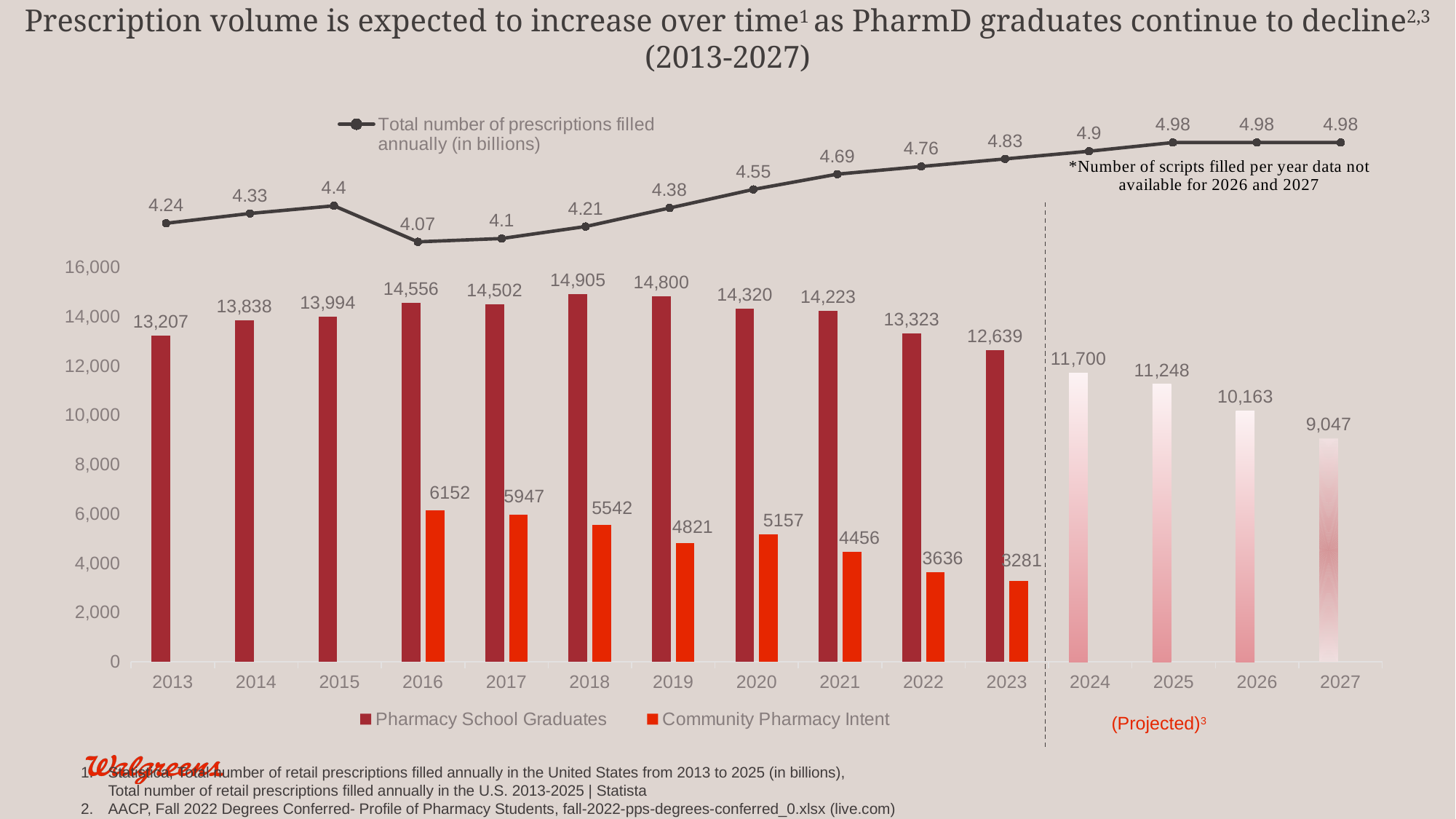
What is the total number of prescriptions filled annually (in billions) shown for 2023? 4.83 What is the value for Pharmacy School Graduates in 2018? 14,905 In which year is the Pharmacy School Graduates value highest? 2018 What kind of chart is shown on the slide? Combined bar and line chart How many years are shown on the x axis? 15 In which year is the Community Pharmacy Intent value lowest? 2023 What is the value for Community Pharmacy Intent in 2016? 6152 How many series does the legend below the x axis list? 2 Do the Community Pharmacy Intent values rise or fall from 2016 to 2023? Fall What is the projected value for Pharmacy School Graduates in 2027? 9,047 Which year has the larger Pharmacy School Graduates value, 2016 or 2017? 2016 What is the difference between the Pharmacy School Graduates values for 2013 and 2023? 568